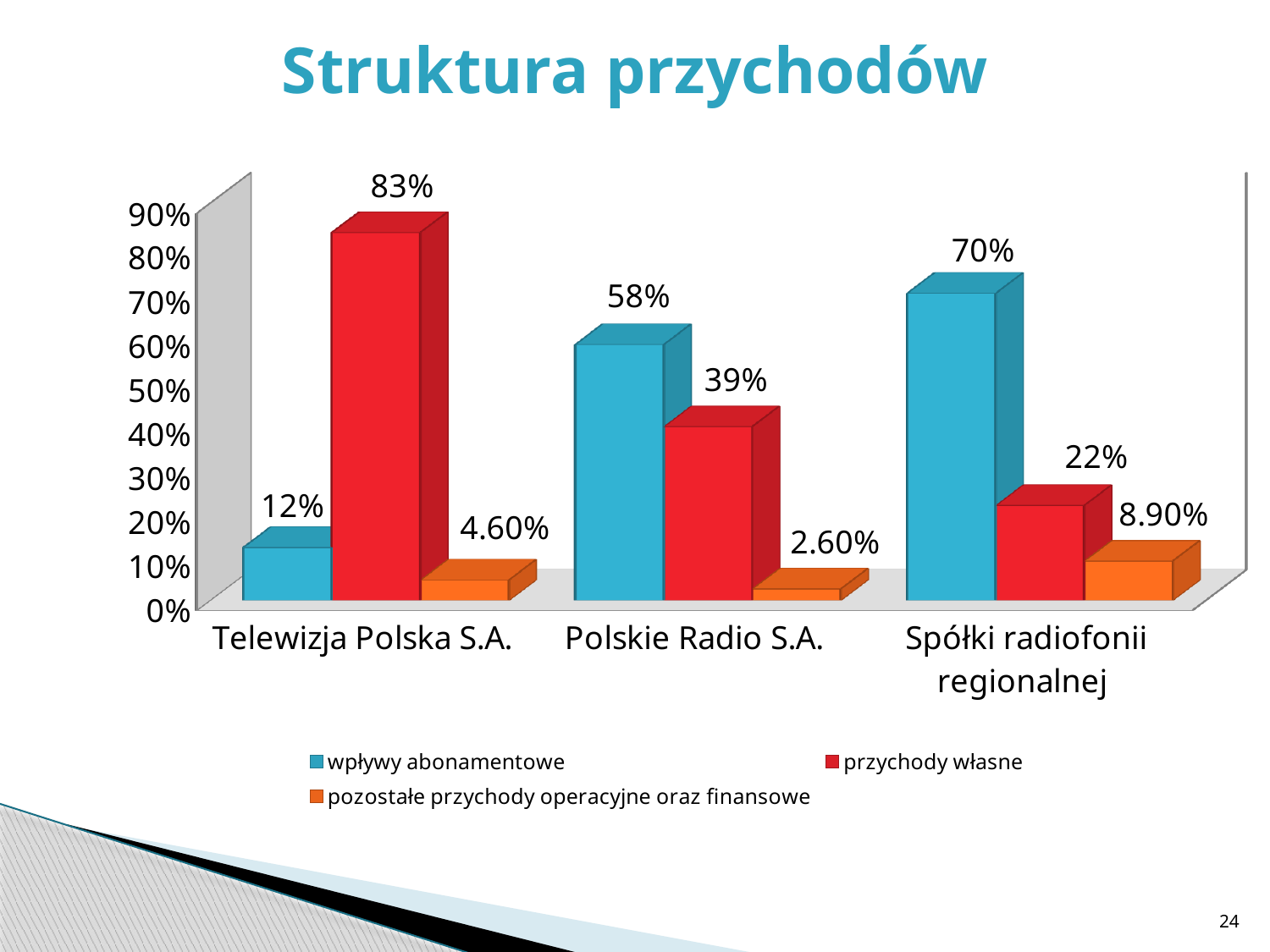
Which category has the highest value for przychody własne? Telewizja Polska S.A. What is the value of pozostałe przychody operacyjne oraz finansowe for Spółki radiofonii regionalnej? 8.90% What kind of chart is shown on the slide? bar chart Which is larger for Polskie Radio S.A.: wpływy abonamentowe or przychody własne? wpływy abonamentowe What is the title of the slide? Struktura przychodów How many series does the legend list? 3 What is the value of przychody własne for Polskie Radio S.A.? 39% What is the difference between wpływy abonamentowe for Spółki radiofonii regionalnej and for Polskie Radio S.A.? 12% How many categories are shown on the x axis? 3 What is the value of wpływy abonamentowe for Telewizja Polska S.A.? 12% Is the value of przychody własne for Spółki radiofonii regionalnej greater or less than 30%? less Which category has the lowest value for wpływy abonamentowe? Telewizja Polska S.A.